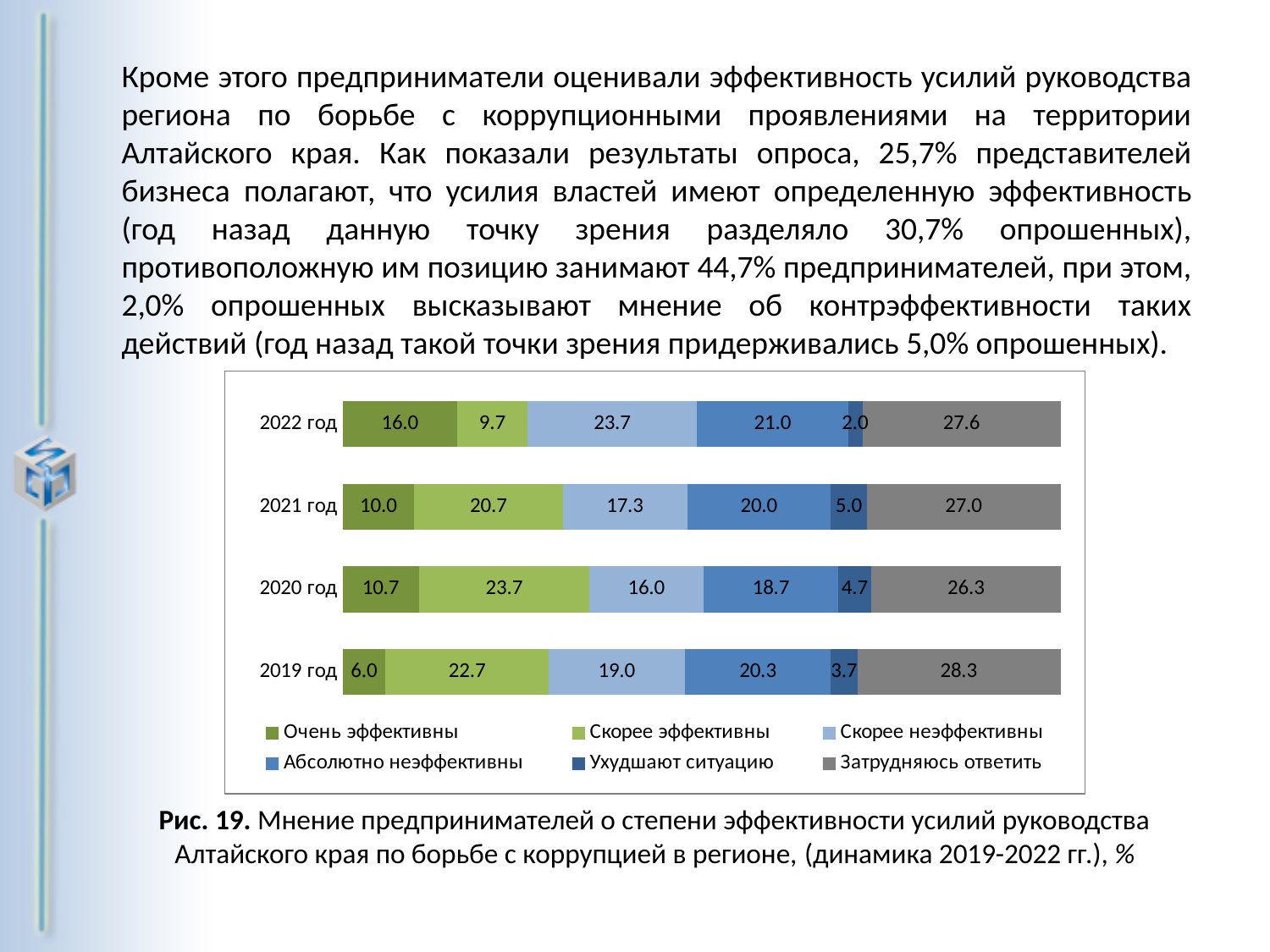
How many series does the legend list? 6 What kind of chart is shown on the slide? Stacked bar chart What is the value for "Абсолютно неэффективны" in 2020 год? 18.7 Which year has the larger value for "Скорее неэффективны": 2022 год or 2021 год? 2022 год Which year has the highest value for "Скорее эффективны"? 2020 год Which year has the lowest value for "Очень эффективны"? 2019 год What is the total of the stacked bar for 2022 год? 100.0 How many years (bars) are shown in the chart? 4 What is the difference between the "Затрудняюсь ответить" values for 2019 год and 2020 год? 2.0 What is the value for "Очень эффективны" in 2022 год? 16.0 What colour represents "Затрудняюсь ответить" in the legend? Grey What is the value for "Ухудшают ситуацию" in 2021 год? 5.0